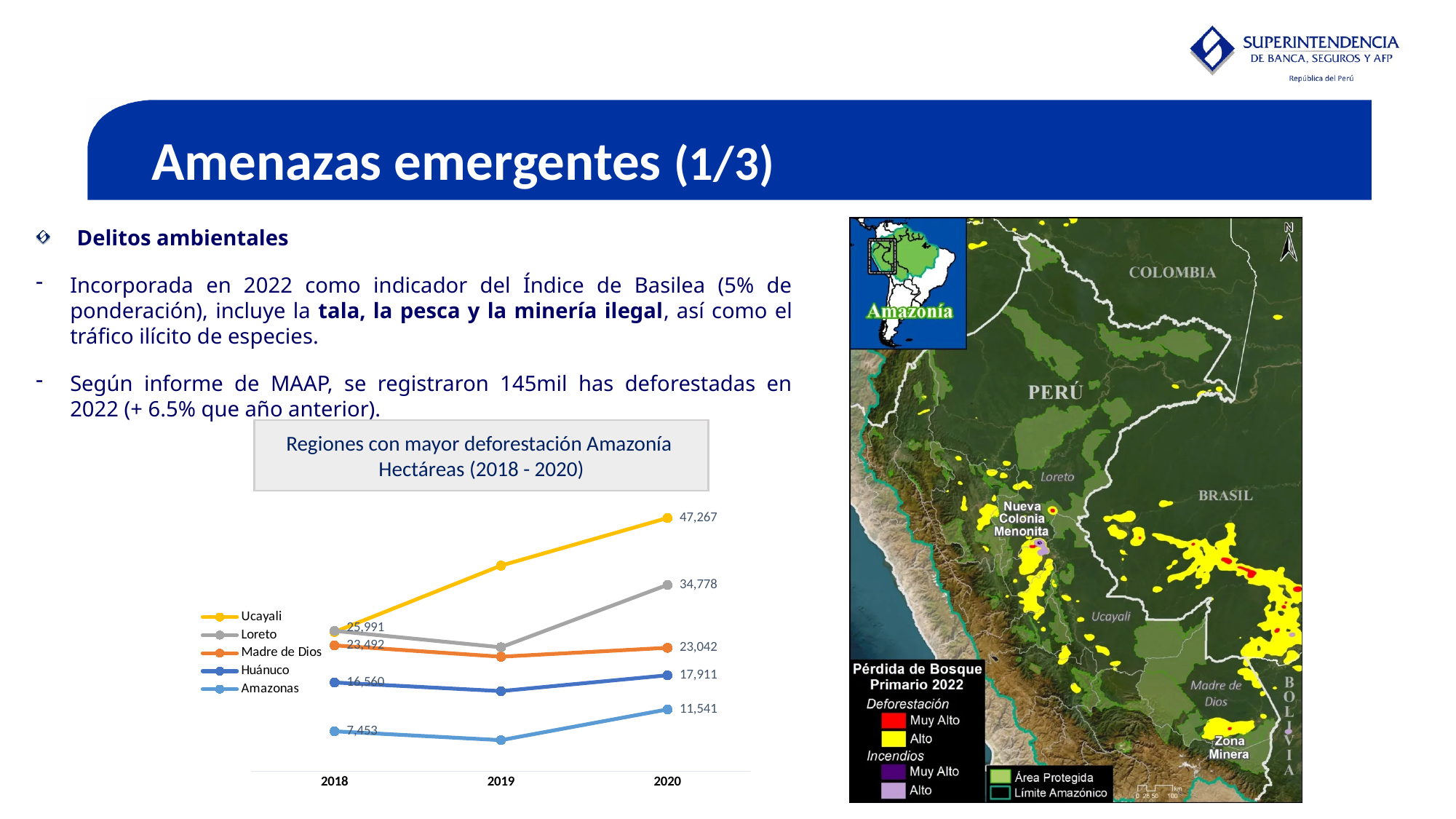
What is the value for Amazonas in 2018? 7,453 What is the value for Ucayali in 2020? 47,267 Which region has the lowest value in 2020? Amazonas What is the value for Loreto in 2020? 34,778 What kind of chart is shown on the slide? Line chart What is the difference between Ucayali and Loreto in 2020? 12,489 By how much did the value for Amazonas increase from 2018 to 2020? 4,088 Which region has the highest value in 2020? Ucayali Does the value for Ucayali rise or fall from 2018 to 2020? Rise What is the value for Huánuco in 2020? 17,911 How many series does the legend list? 5 What is the value for Madre de Dios in 2020? 23,042